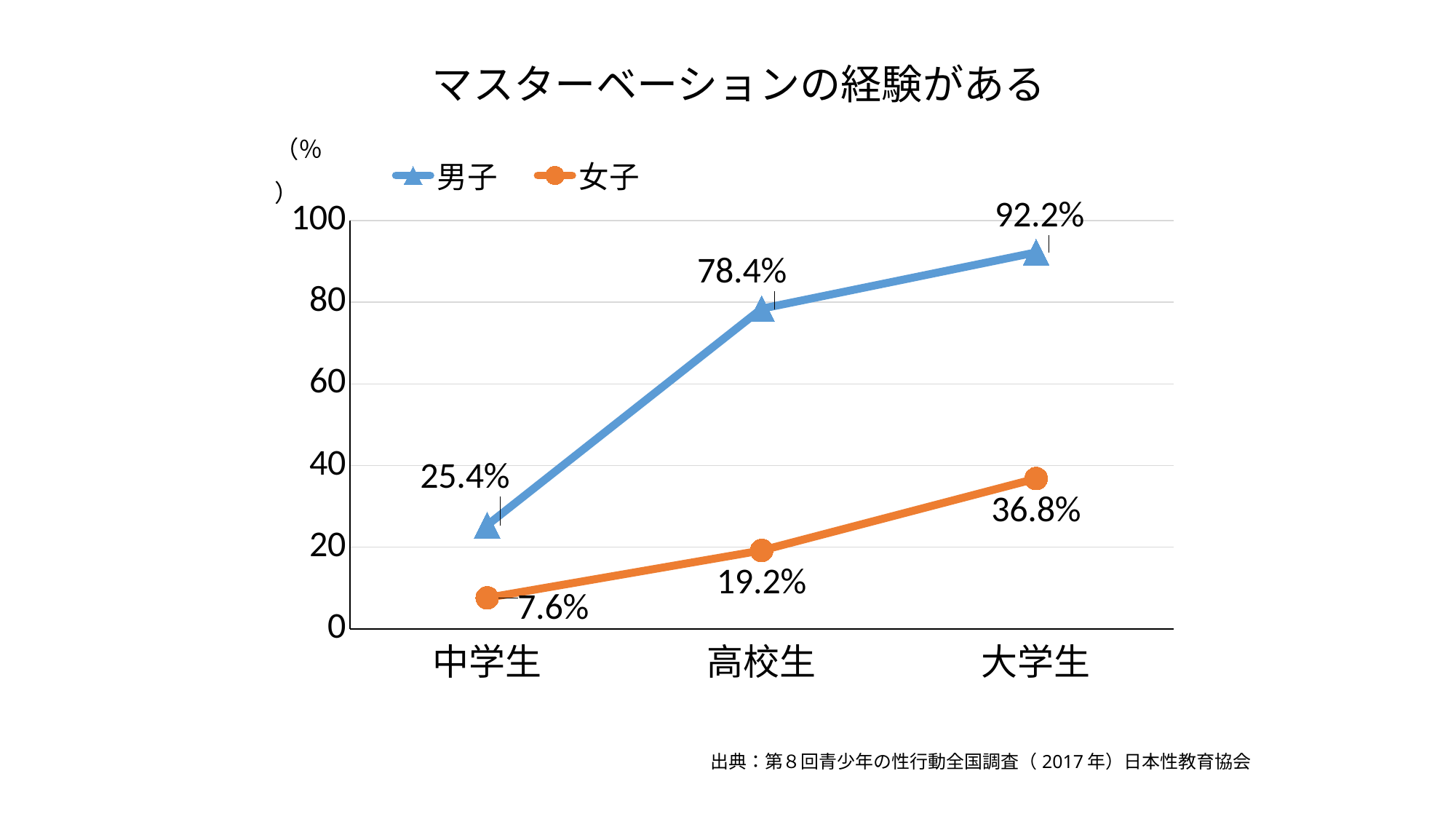
What is the value for 男子 at 中学生? 25.4% What is the value for 女子 at 中学生? 7.6% What is the value for 女子 at 高校生? 19.2% At which category is the 男子 series lowest? 中学生 How many series does the legend list? 2 At which category is the 女子 series highest? 大学生 How many categories are shown on the x axis? 3 What is the value for 男子 at 大学生? 92.2% What kind of chart is this? line chart Which is larger at 高校生, 男子 or 女子? 男子 Do the values for 男子 rise or fall from 中学生 to 大学生? rise What is the difference between 男子 and 女子 at 大学生? 55.4%